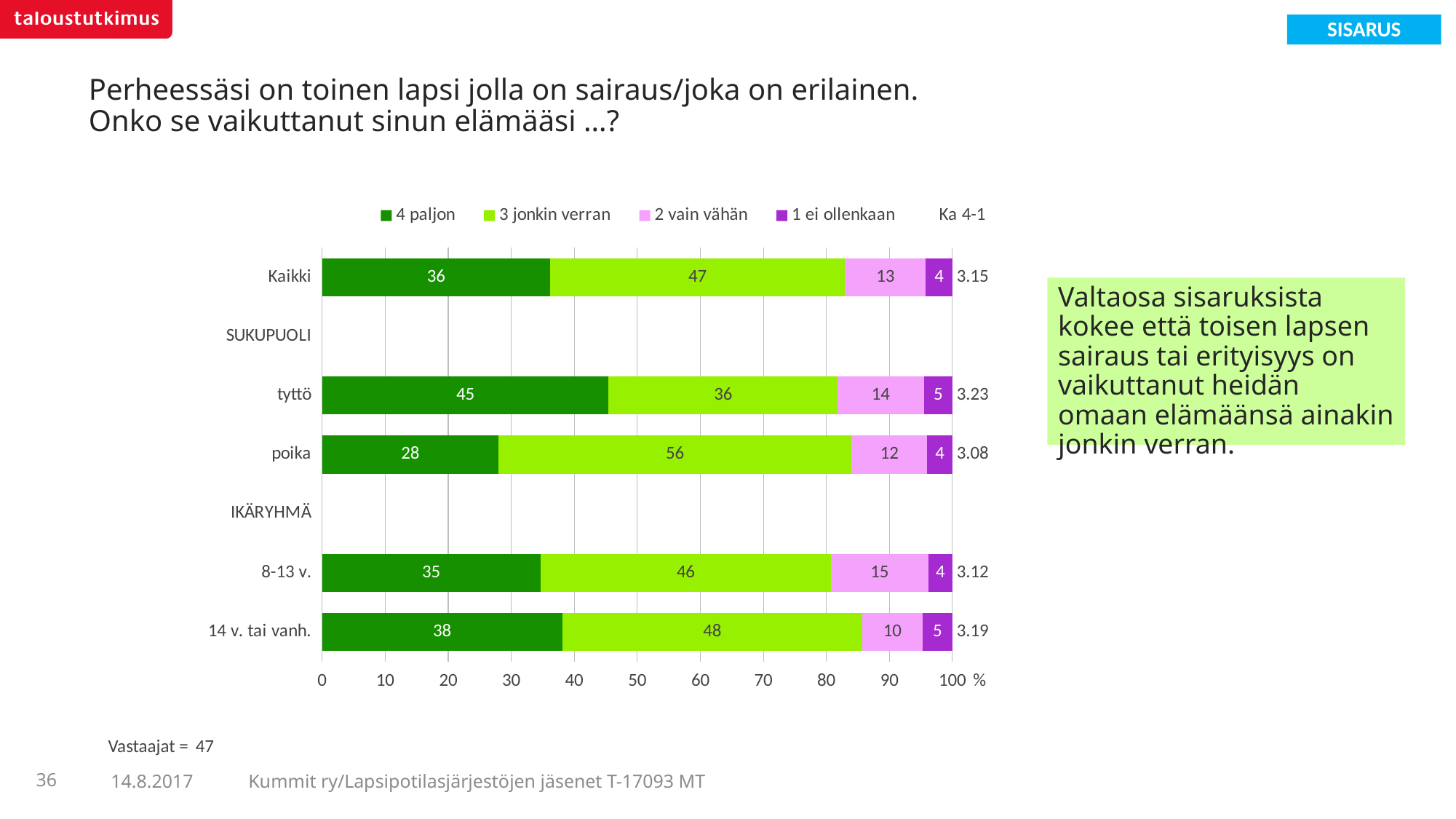
How many categories have bars plotted in the chart? 5 Which category has the lowest '4 paljon' value? poika What percentage of 'Kaikki' answered '4 paljon'? 36 What kind of chart is shown on the slide? Stacked bar chart What is the total of the stacked bar for '14 v. tai vanh.' (38 + 48 + 10 + 5)? 101 How many series does the legend list for the stacked bars? 4 What is the difference between the '3 jonkin verran' values for 'poika' and 'tyttö'? 20 Which is larger: the '2 vain vähän' value for '8-13 v.' or for '14 v. tai vanh.'? 8-13 v. What is the '2 vain vähän' value for '8-13 v.'? 15 What is the Ka (mean) value shown for 'tyttö'? 3.23 Which category has the highest '4 paljon' value? tyttö What is the '3 jonkin verran' value for 'poika'? 56